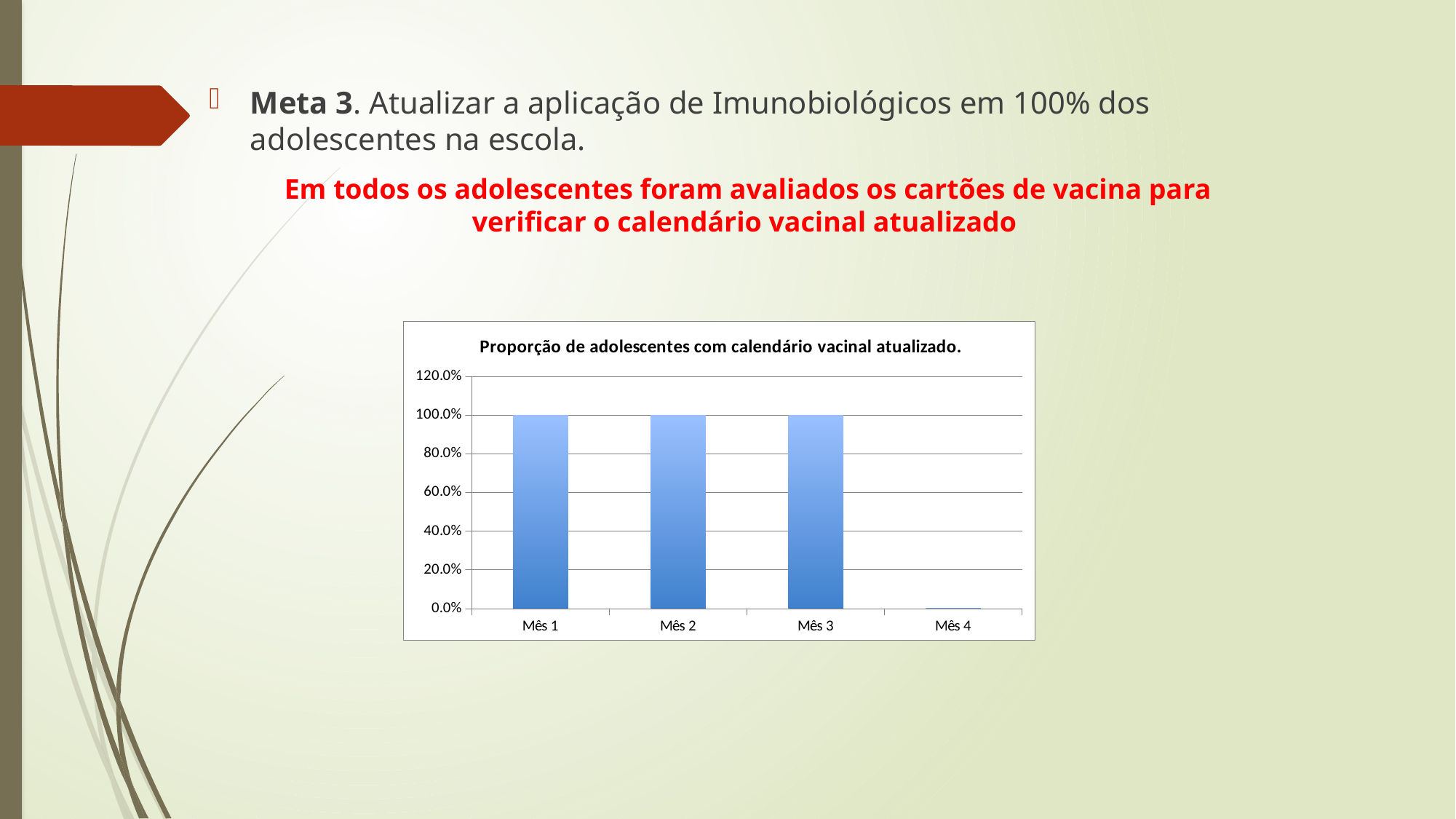
What kind of chart is shown on the slide? bar chart What is the value for Mês 1? 100.0% What is the value for Mês 4? 0.0% What is the highest tick label shown on the y axis of the chart? 120.0% What is the value for Mês 2? 100.0% Which category has the lowest value? Mês 4 Is the value for Mês 2 greater or less than 80.0%? greater Which is larger, the value for Mês 3 or the value for Mês 4? Mês 3 What is the title of the chart? Proporção de adolescentes com calendário vacinal atualizado. How many categories are shown on the x axis of the chart? 4 Does the value fall or rise from Mês 3 to Mês 4? fall What is the difference between the value for Mês 1 and the value for Mês 4? 100.0%